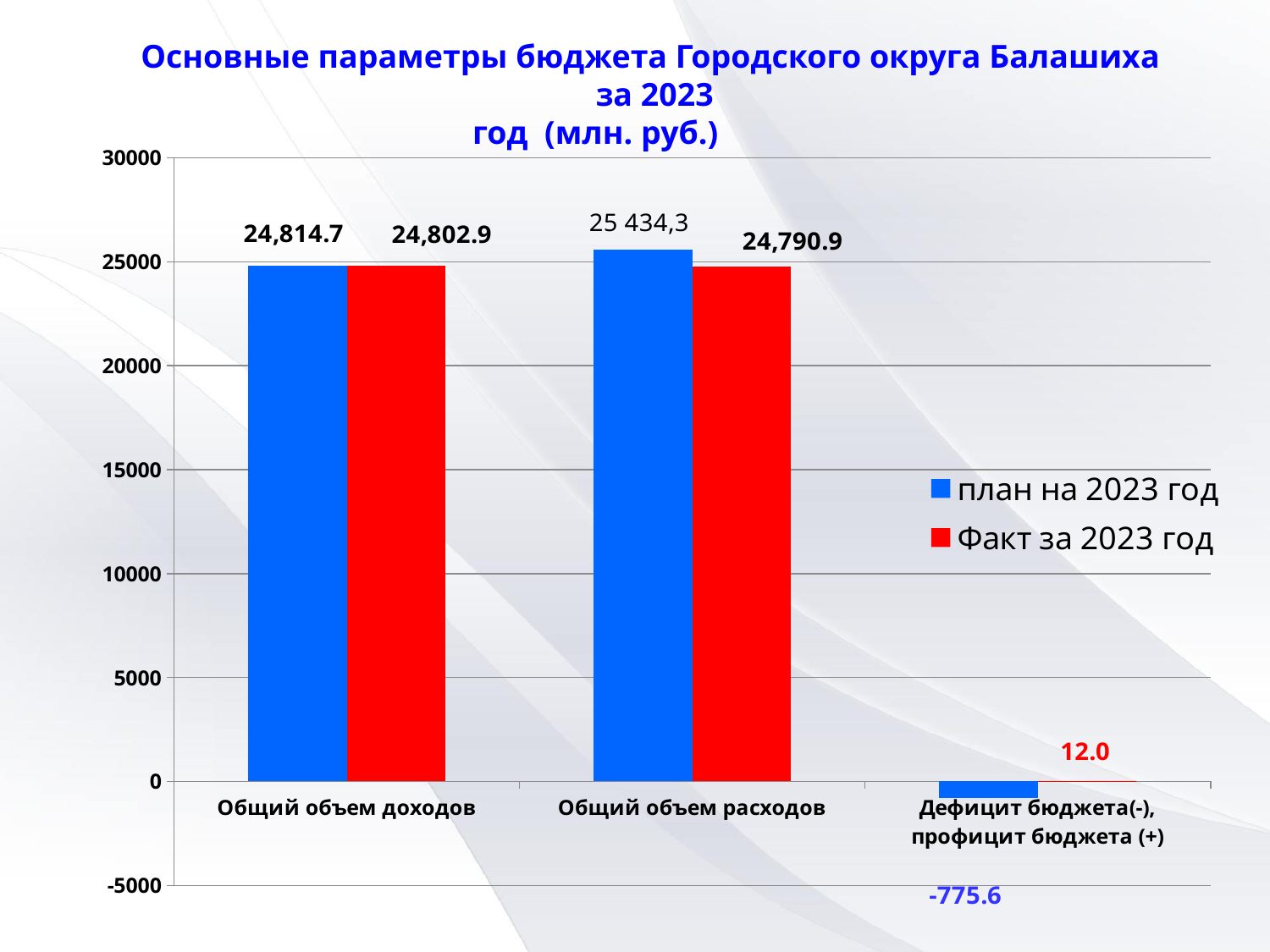
Which category has the lowest value in the chart? Дефицит бюджета(-), профицит бюджета (+) What is the actual value (Факт за 2023 год) for Общий объем доходов? 24,802.9 What is the difference between the planned and actual values for Общий объем доходов? 11.8 Which is larger: the planned value for Общий объем расходов or the planned value for Общий объем доходов? Общий объем расходов What is the planned value (план на 2023 год) for Общий объем доходов? 24,814.7 What is the actual value (Факт за 2023 год) for Общий объем расходов? 24,790.9 How many series does the legend list? 2 What kind of chart is shown on the slide? Bar chart How many categories are shown on the x axis? 3 What is the actual value (Факт за 2023 год) for Дефицит бюджета(-), профицит бюджета (+)? 12.0 What is the planned value (план на 2023 год) for Дефицит бюджета(-), профицит бюджета (+)? -775.6 What is the planned value (план на 2023 год) for Общий объем расходов? 25 434,3